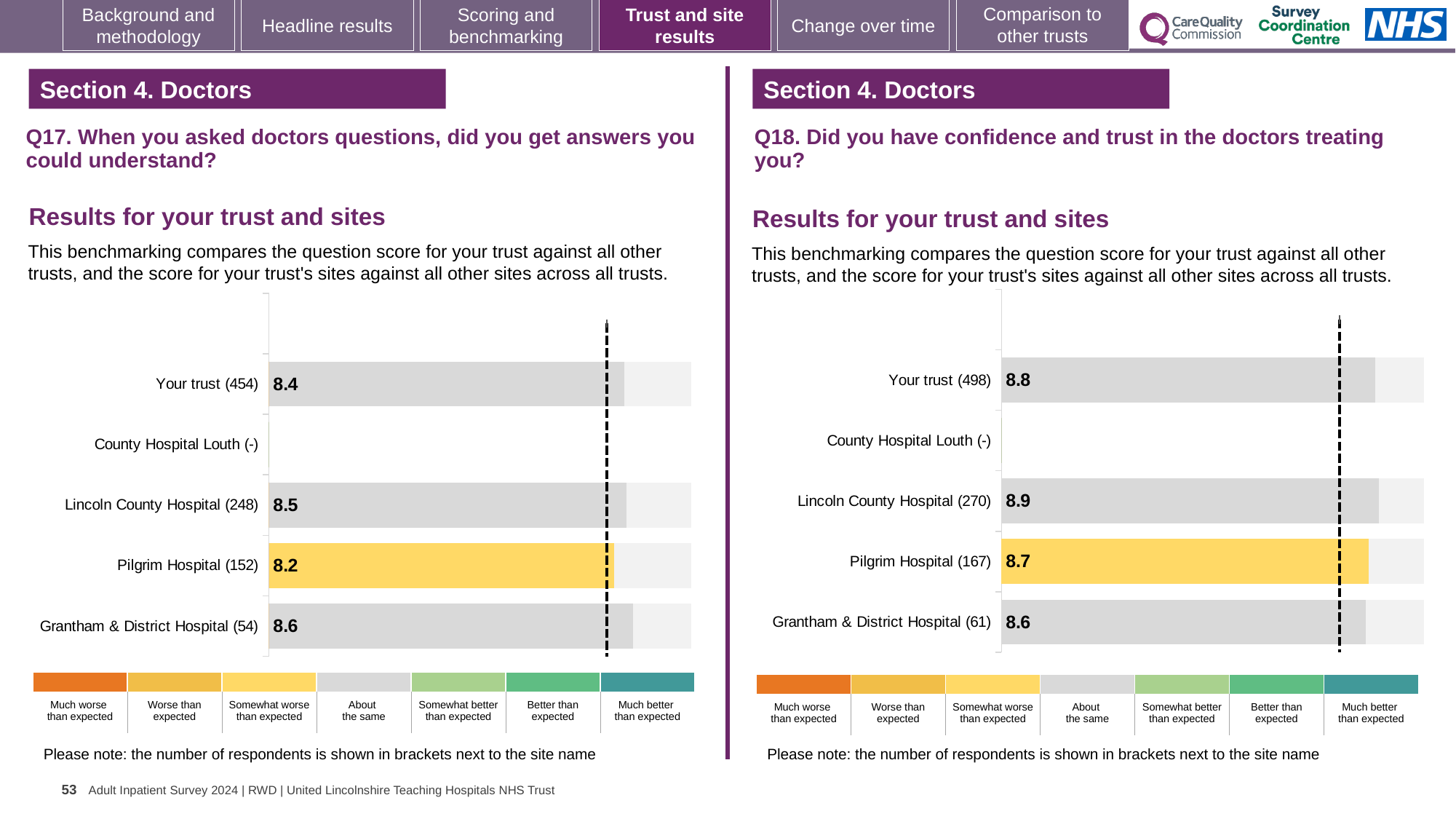
In the Q17 chart on the left, which site has the highest score? Grantham & District Hospital In the Q18 chart on the right, what is the score for Pilgrim Hospital? 8.7 What kind of chart is used for the Q17 results on the left? bar chart In the Q18 chart on the right, is the score for Your trust larger or smaller than the score for Grantham & District Hospital? larger In the Q18 chart on the right, which site has the lowest score? Grantham & District Hospital In the Q17 chart on the left, what is the score for Lincoln County Hospital? 8.5 In the Q17 chart on the left, which benchmark category does the colour of the Pilgrim Hospital bar correspond to? Somewhat worse than expected In the Q18 chart on the right, what is the difference between the scores for Lincoln County Hospital and Your trust? 0.1 In the Q18 chart on the right, which site has the highest score? Lincoln County Hospital In the Q17 chart on the left, what is the score for Your trust? 8.4 In the Q17 chart on the left, which site has the lowest score? Pilgrim Hospital In the Q17 chart on the left, what is the difference between the scores for Grantham & District Hospital and Pilgrim Hospital? 0.4